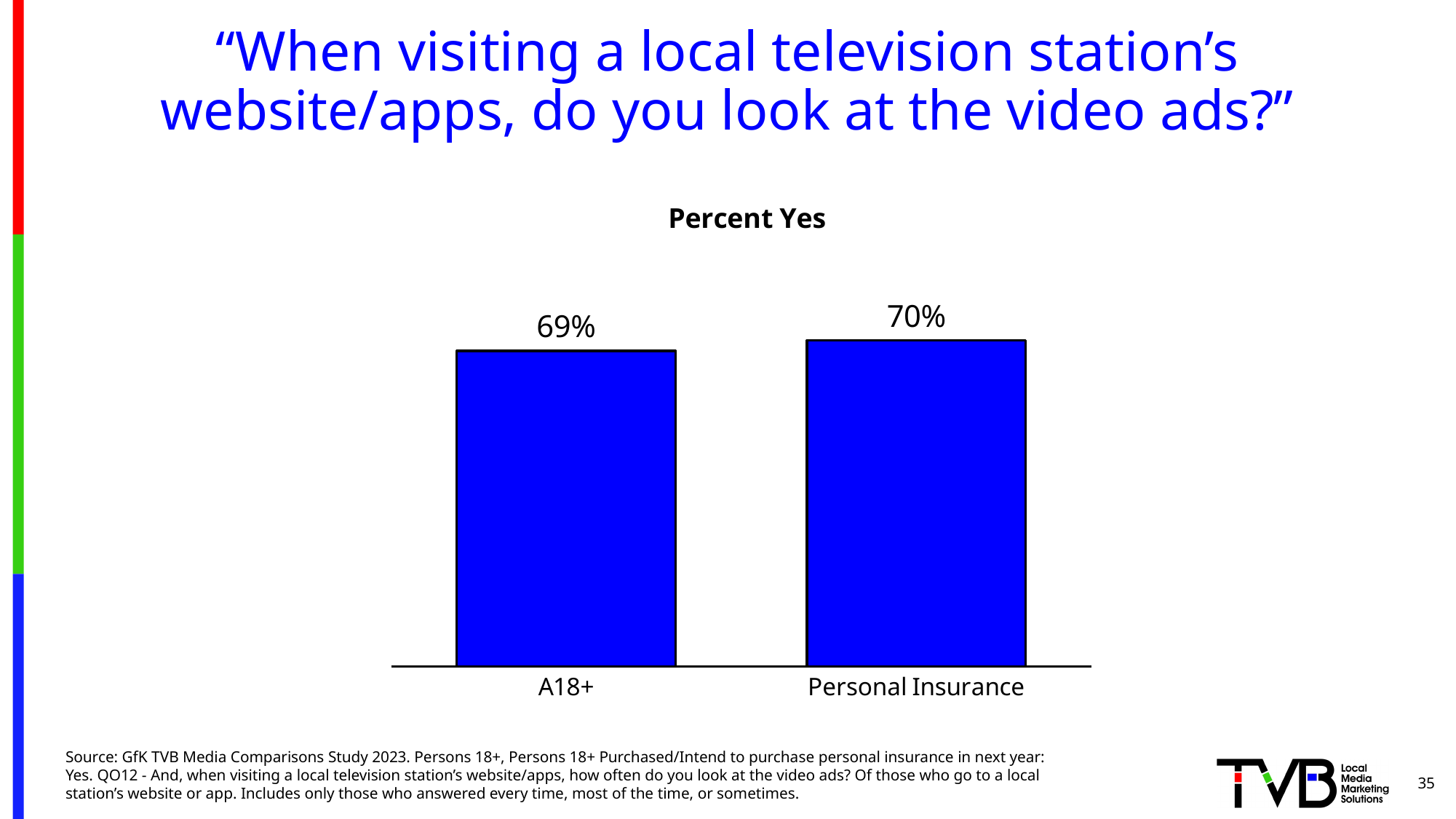
Is the value for Personal Insurance larger or smaller than the value for A18+? larger What is the difference between the Personal Insurance and A18+ values? 1% What is the title of the chart? Percent Yes Which category has the higher Percent Yes value? Personal Insurance How many categories are shown in the chart? 2 Do the values rise or fall from A18+ to Personal Insurance? rise What colour are the bars in the chart? blue What kind of chart is shown on the slide? bar chart Which category has the lower Percent Yes value? A18+ What is the Percent Yes value for Personal Insurance? 70% What is the Percent Yes value for A18+? 69%